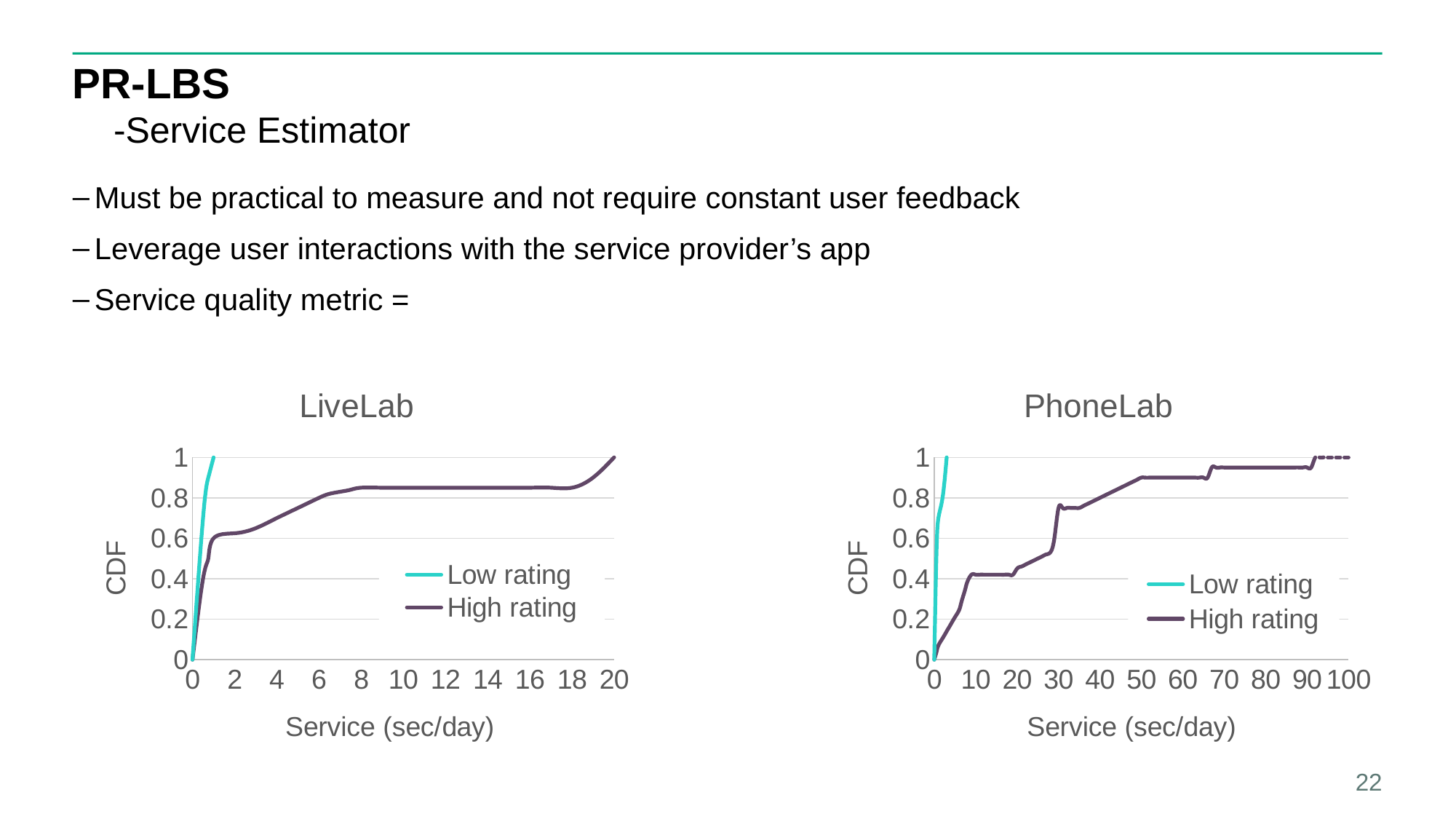
In the PhoneLab chart, is the High rating CDF at 50 sec/day greater or less than 0.8? greater What is the largest value shown on the x axis of the PhoneLab chart? 100 What kind of chart is the LiveLab chart? line chart In the LiveLab chart, is the High rating CDF at 4 sec/day greater or less than 0.8? less In the PhoneLab chart, is the High rating CDF at 20 sec/day greater or less than 0.6? less How many series does the legend of the PhoneLab chart list? 2 In the LiveLab chart, which series is plotted in teal? Low rating In the PhoneLab chart, does the High rating CDF rise or fall as service (sec/day) increases? rise In the LiveLab chart, which series reaches a CDF of 1 at a smaller service value, Low rating or High rating? Low rating What is the x-axis title of the PhoneLab chart? Service (sec/day)